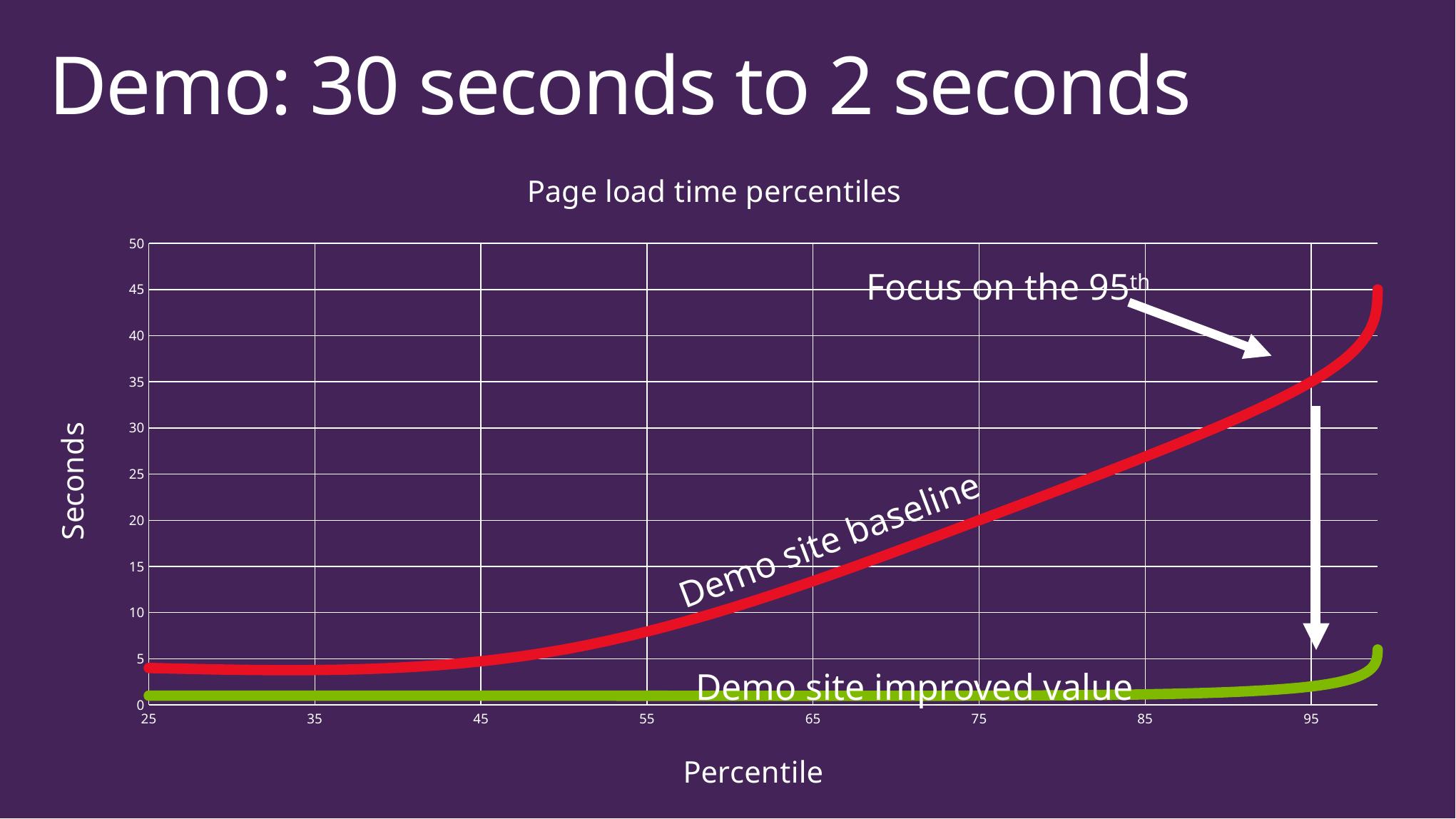
Is the 'Demo site baseline' value at the 75th percentile greater or less than 15 seconds? greater What kind of chart is shown on the slide? Line chart Is the 'Demo site baseline' value at the 25th percentile greater or less than 10 seconds? less What is the title of the chart? Page load time percentiles How many data series (lines) are plotted on the chart? 2 Which series reaches the highest value on the chart? Demo site baseline Does the 'Demo site baseline' line rise or fall as the percentile increases from 45 to 95? Rises What colour is the 'Demo site baseline' line? Red Is the 'Demo site improved value' at the 95th percentile greater or less than 5 seconds? less At the 85th percentile, which series has the higher value: 'Demo site baseline' or 'Demo site improved value'? Demo site baseline Which series has the lowest values across the chart? Demo site improved value